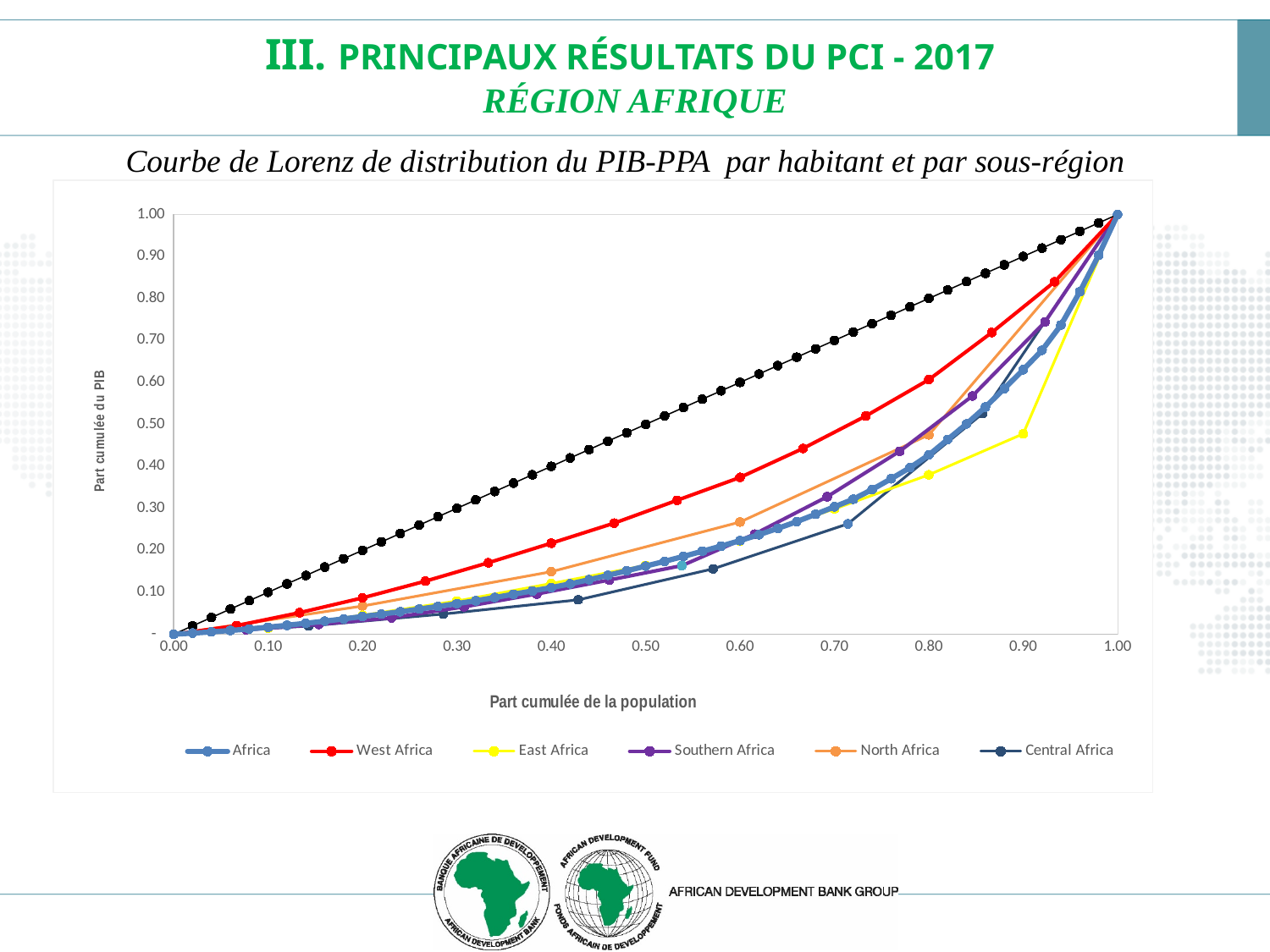
At a cumulative population share of 0.90, which is higher: West Africa or East Africa? West Africa What kind of chart is shown on the slide? line chart Which series has the highest cumulative GDP share at a cumulative population share of 0.70? West Africa Is the value for West Africa at a cumulative population share of 0.60 greater or less than 0.30? greater Is the value for Central Africa at a cumulative population share of 0.57 greater or less than 0.20? less Which series has the lowest cumulative GDP share at a cumulative population share of 0.70? Central Africa How many series does the legend list? 6 What is the title of the chart? Courbe de Lorenz de distribution du PIB-PPA par habitant et par sous-région At a cumulative population share of 0.70, which is higher: West Africa or Central Africa? West Africa Is the value for Central Africa at a cumulative population share of 0.70 greater or less than 0.30? less Do the curves rise or fall as the cumulative population share increases along the x axis? rise What is the label of the vertical axis? Part cumulée du PIB